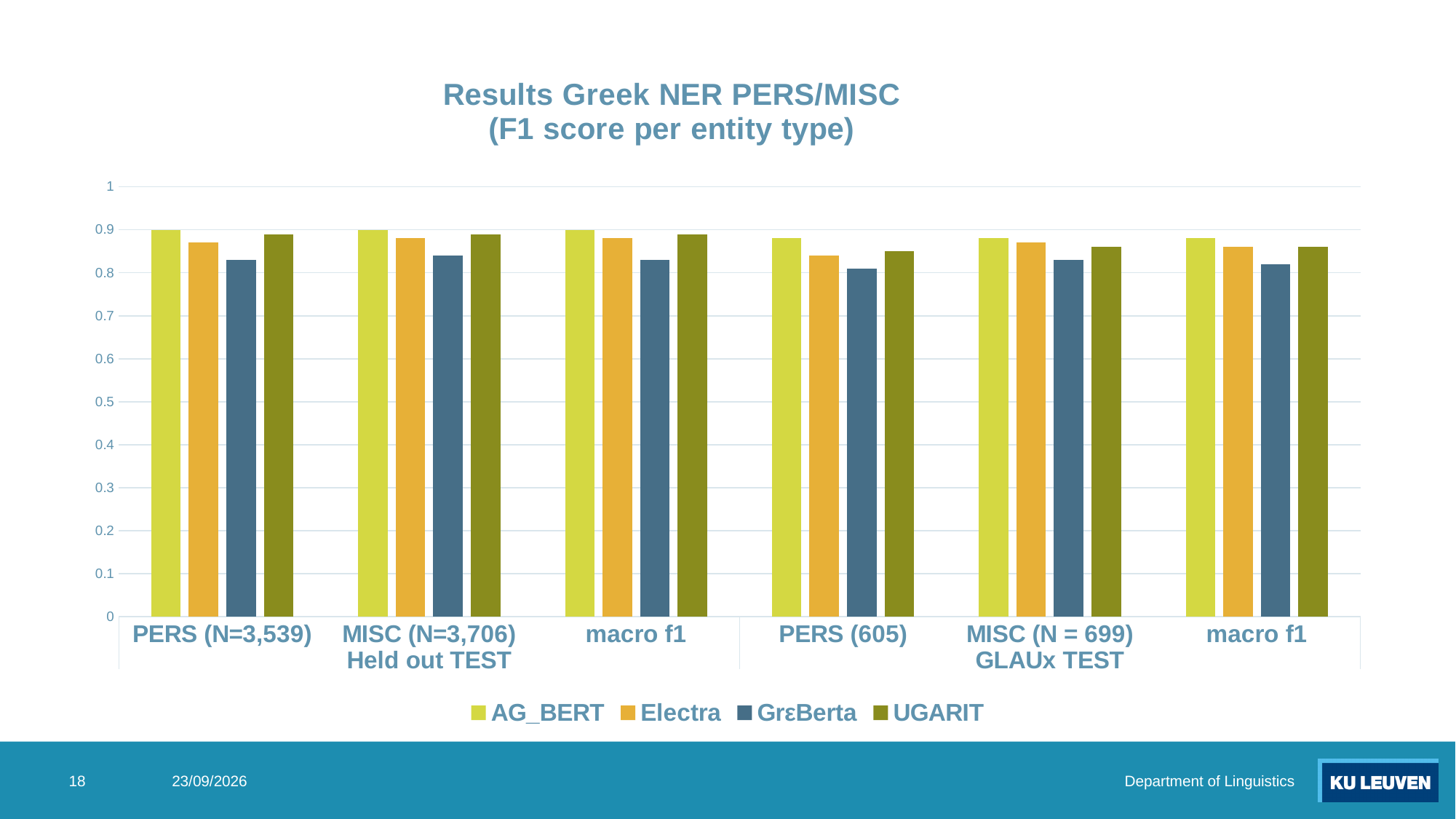
In the MISC (N=3,706) group, which is larger: Electra or GrεBerta? Electra Which series has the lowest bar in the PERS (N=3,539) group? GrεBerta What kind of chart is shown on the slide? bar chart What is the title of the chart? Results Greek NER PERS/MISC (F1 score per entity type) Which series has the lowest bar in the PERS (605) group? GrεBerta Is the value for GrεBerta in the PERS (605) group greater or less than 0.9? less Is the value for Electra in the PERS (N=3,539) group greater or less than 0.8? greater In the macro f1 group under GLAUx TEST, which is larger: AG_BERT or GrεBerta? AG_BERT How many series does the legend list? 4 How many category groups are shown along the x axis? 6 Which series has the lowest bar in the MISC (N = 699) group? GrεBerta Which two test sets are labelled on the x axis? Held out TEST and GLAUx TEST